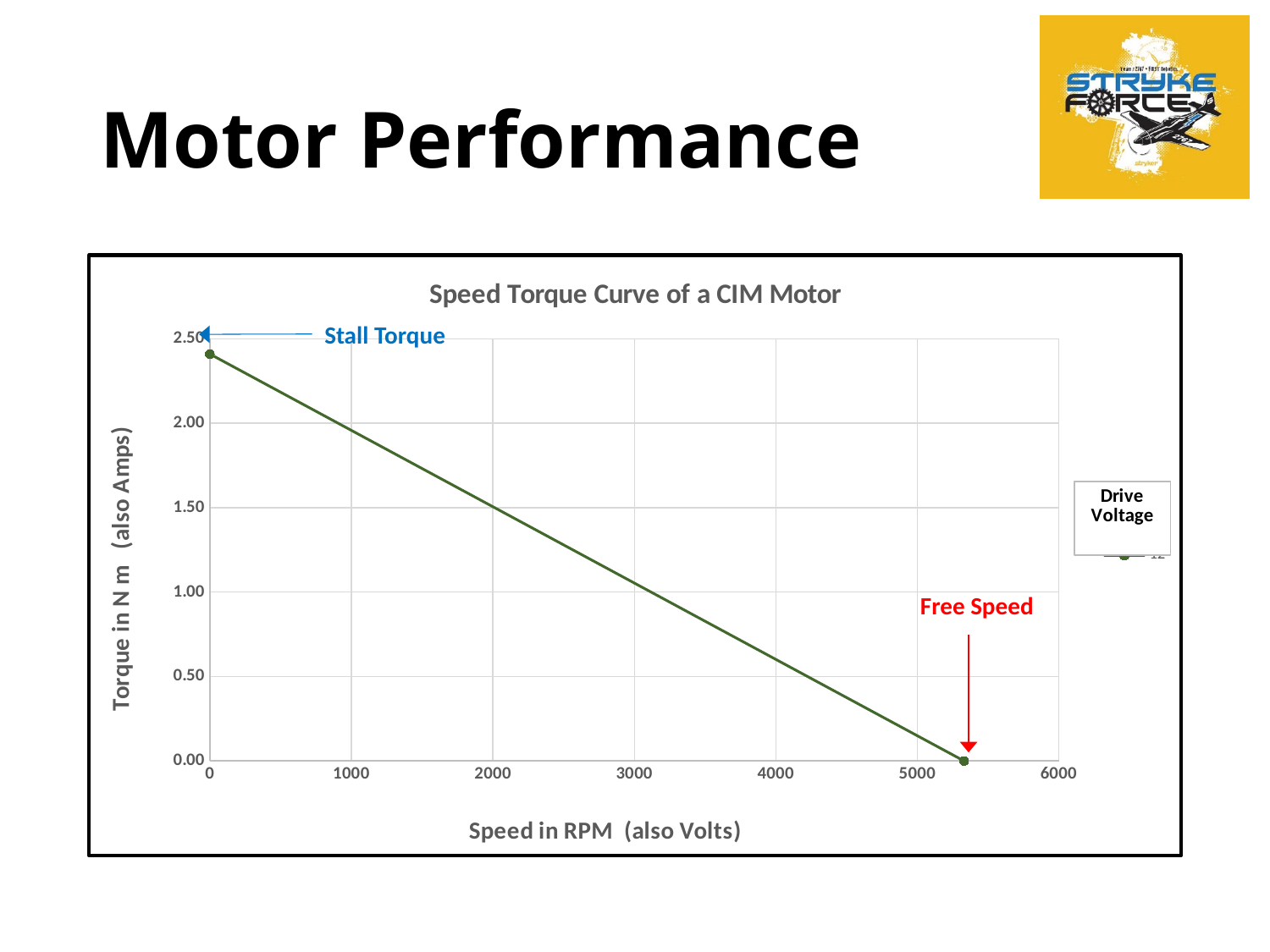
Is the torque at a speed of 2000 RPM greater or less than 1.00? greater How many data points are plotted on the line? 2 Does torque rise or fall as speed increases along the x axis? fall What is the torque value at the point labelled Free Speed? 0.00 What is the title of the chart? Speed Torque Curve of a CIM Motor Is the torque at a speed of 3000 RPM greater or less than 1.50? less What is the label of the x axis? Speed in RPM (also Volts) Is the speed at the Free Speed point greater or less than 5000? greater Which point has the higher torque, the Stall Torque point or the Free Speed point? Stall Torque What is the speed value at the point labelled Stall Torque? 0 What kind of chart is shown on the slide? line chart